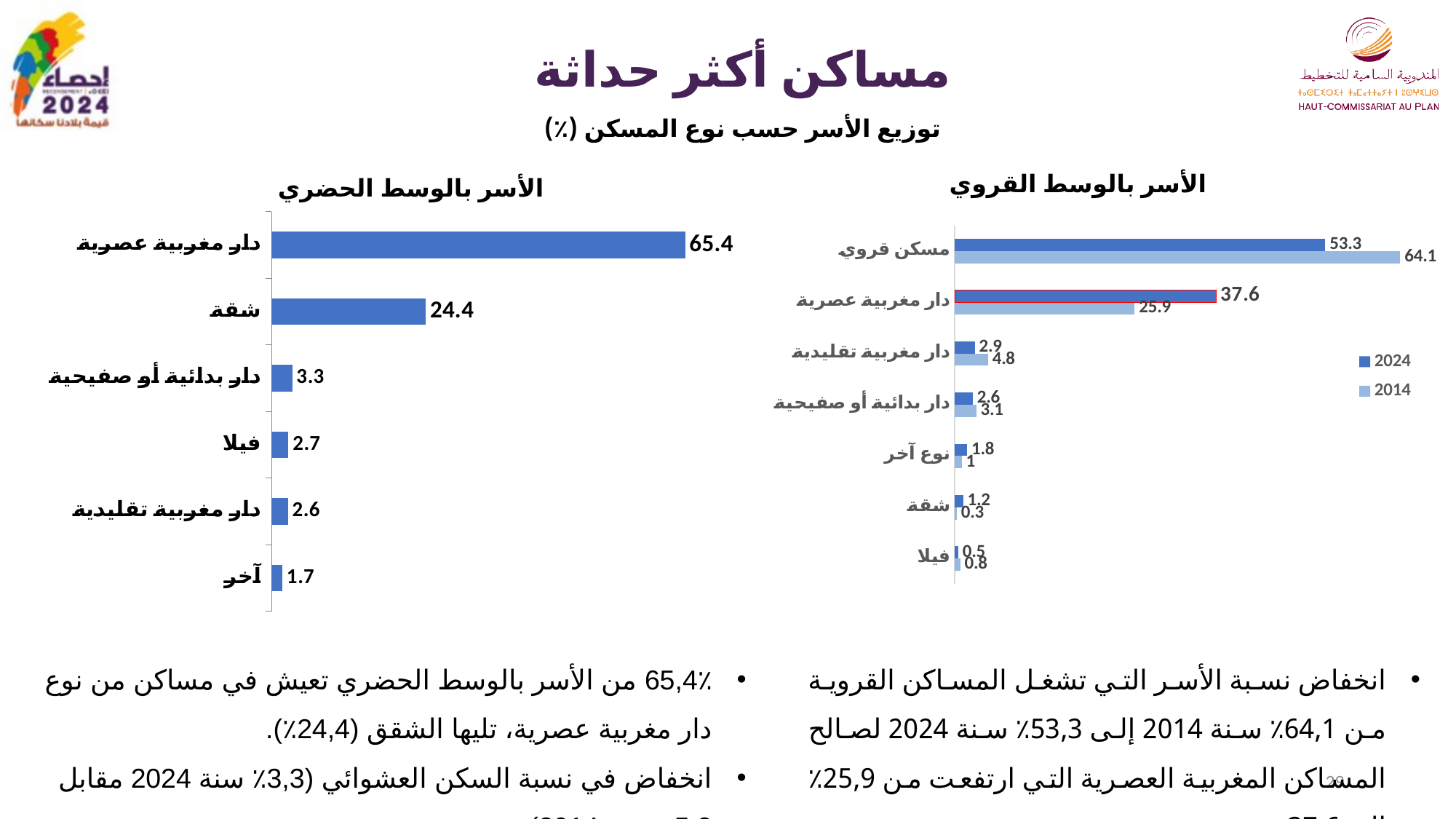
In the chart titled "الأسر بالوسط القروي", what is the 2014 value for "دار مغربية عصرية"? 25.9 What type of chart is the chart titled "الأسر بالوسط الحضري"? Bar chart In the chart titled "الأسر بالوسط القروي", how many series does the legend list? 2 In the chart titled "الأسر بالوسط القروي", which is larger for "دار مغربية تقليدية": the 2024 value or the 2014 value? 2014 In the chart titled "الأسر بالوسط الحضري", what is the difference between the values for "دار مغربية عصرية" and "شقة"? 41.0 In the chart titled "الأسر بالوسط الحضري", what is the value for "دار مغربية عصرية"? 65.4 In the chart titled "الأسر بالوسط القروي", what is the 2024 value for "مسكن قروي"? 53.3 In the chart titled "الأسر بالوسط الحضري", which category has the lowest value? آخر In the chart titled "الأسر بالوسط القروي", which category has the highest 2024 value? مسكن قروي In the chart titled "الأسر بالوسط الحضري", how many categories are shown? 6 In the chart titled "الأسر بالوسط الحضري", what is the value for "شقة"? 24.4 In the chart titled "الأسر بالوسط القروي", what is the difference between the 2014 and 2024 values for "مسكن قروي"? 10.8